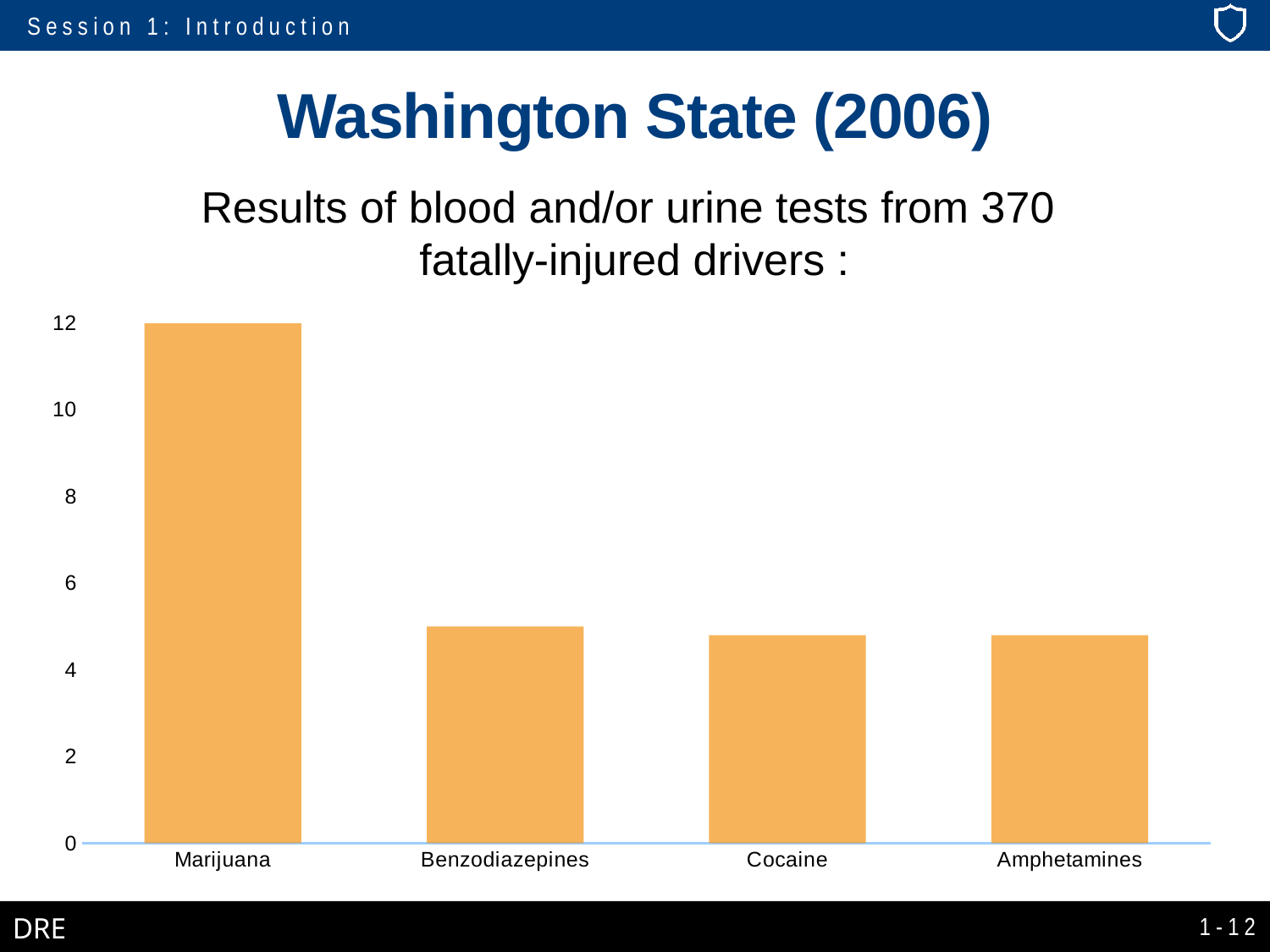
What kind of chart is shown on the slide? bar chart Is the value for Benzodiazepines greater or less than 6? less Is the value for Benzodiazepines greater or less than 4? greater What is the title of the slide containing the chart? Washington State (2006) Is the value for Marijuana greater or less than 10? greater Which has the larger value, Marijuana or Benzodiazepines? Marijuana Which category has the highest bar in the chart? Marijuana Which has the larger value, Amphetamines or Marijuana? Marijuana How many categories are shown on the x axis of the chart? 4 What is the value for Marijuana in the chart? 12